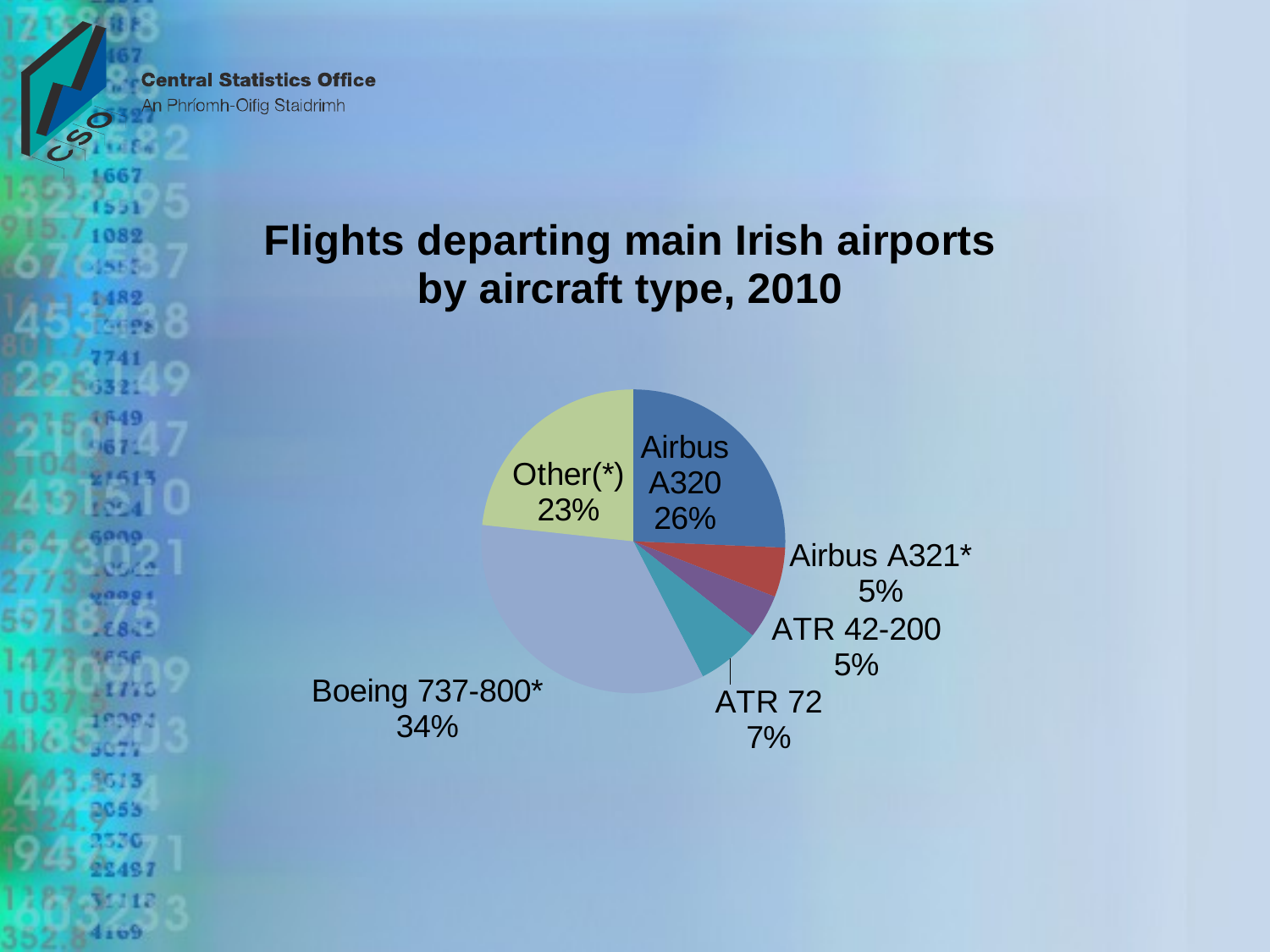
How many slices does the pie chart have? 6 What is the difference in percentage points between the Boeing 737-800* share and the Airbus A320 share? 8 percentage points Which is larger, the share for ATR 72 or the share for Airbus A321*? ATR 72 What is the title of the chart? Flights departing main Irish airports by aircraft type, 2010 What percentage of the pie is labelled Airbus A320? 26% What share of the pie do the two ATR aircraft types (ATR 72 and ATR 42-200) account for together? 12% Which aircraft type has the largest share of the pie? Boeing 737-800* What share of flights departing main Irish airports in 2010 were Boeing 737-800* aircraft? 34% What is the combined share of Airbus A321* and ATR 42-200? 10% What share does the Other(*) slice represent? 23% What kind of chart is shown on the slide? Pie chart What percentage of flights were ATR 72 aircraft? 7%